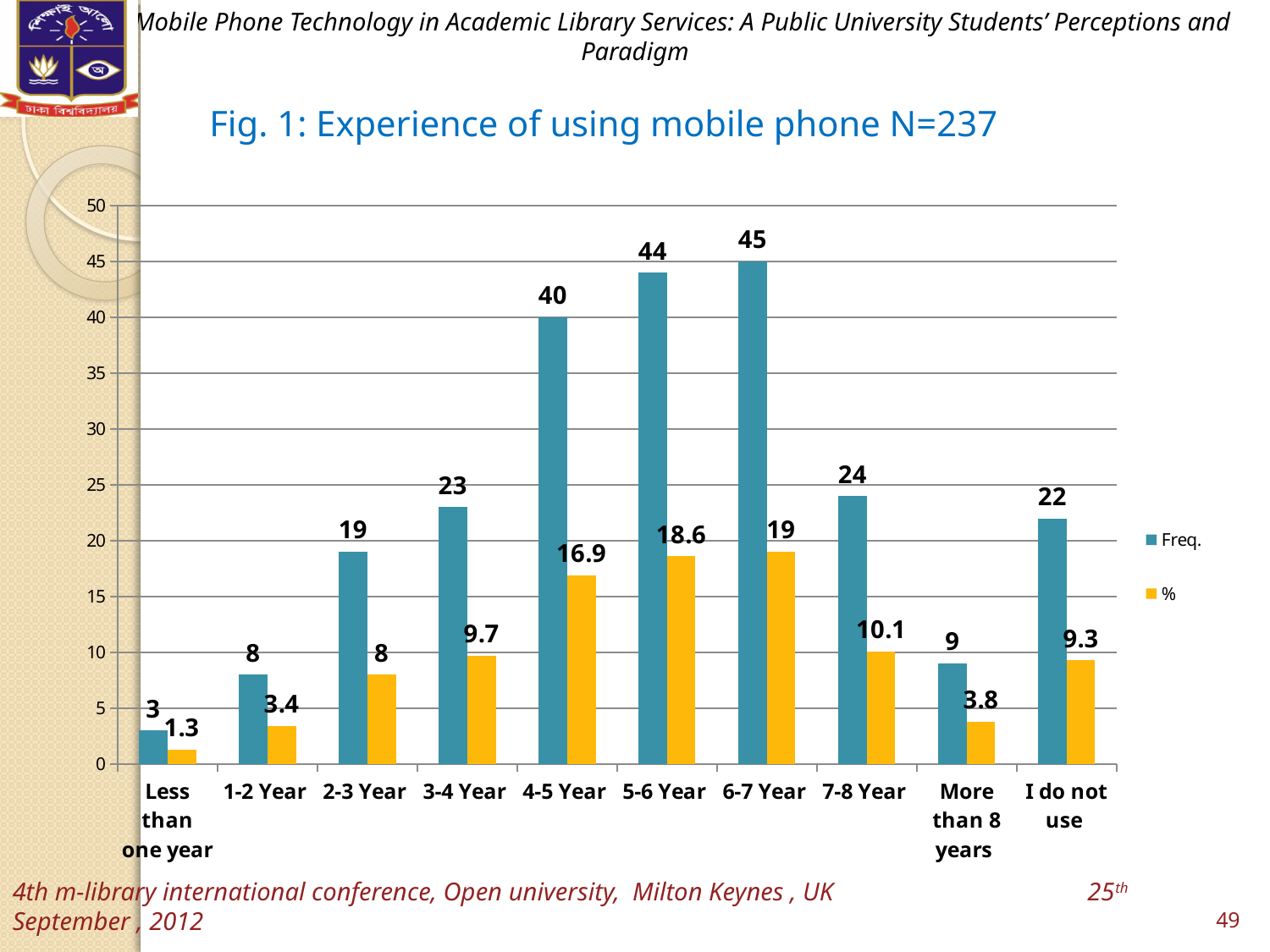
Which is larger, the Freq. value for 3-4 Year or for 'More than 8 years'? 3-4 Year What kind of chart is shown on the slide? bar chart Which category has the highest Freq. value? 6-7 Year What is the Freq. value for the 4-5 Year category? 40 How many series does the legend list? 2 Is the Freq. value for 5-6 Year greater or less than 40? greater What is the Freq. value for the 'I do not use' category? 22 What is the % value for the 5-6 Year category? 18.6 How many categories are shown on the x axis? 10 Which category has the lowest % value? Less than one year What is the difference between the Freq. values for 6-7 Year and 7-8 Year? 21 What is the title of the chart? Fig. 1: Experience of using mobile phone N=237